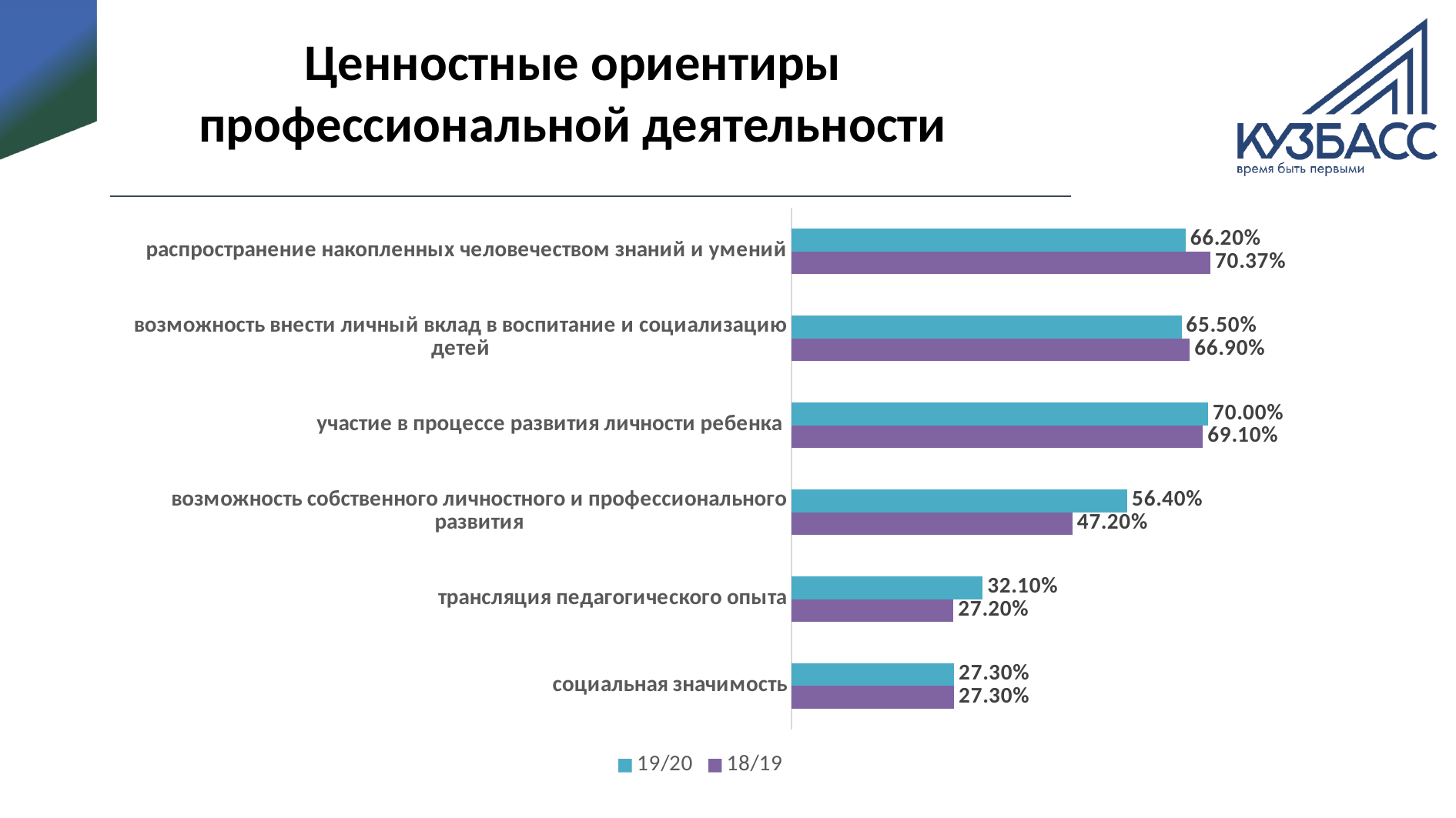
Which series is shown in purple in the legend? 18/19 What is the 18/19 value for 'возможность собственного личностного и профессионального развития'? 47.20% What type of chart is shown on the slide? bar chart What is the 18/19 value for 'распространение накопленных человечеством знаний и умений'? 70.37% What is the 19/20 value for 'трансляция педагогического опыта'? 32.10% For 'трансляция педагогического опыта', which series has the larger value, 19/20 or 18/19? 19/20 What is the difference between the 19/20 and 18/19 values for 'возможность собственного личностного и профессионального развития'? 9.20% Which category has the highest 19/20 value? участие в процессе развития личности ребенка Which category has the highest 18/19 value? распространение накопленных человечеством знаний и умений How many categories are shown in the chart? 6 How many series does the legend list? 2 Which category has the lowest 19/20 value? социальная значимость